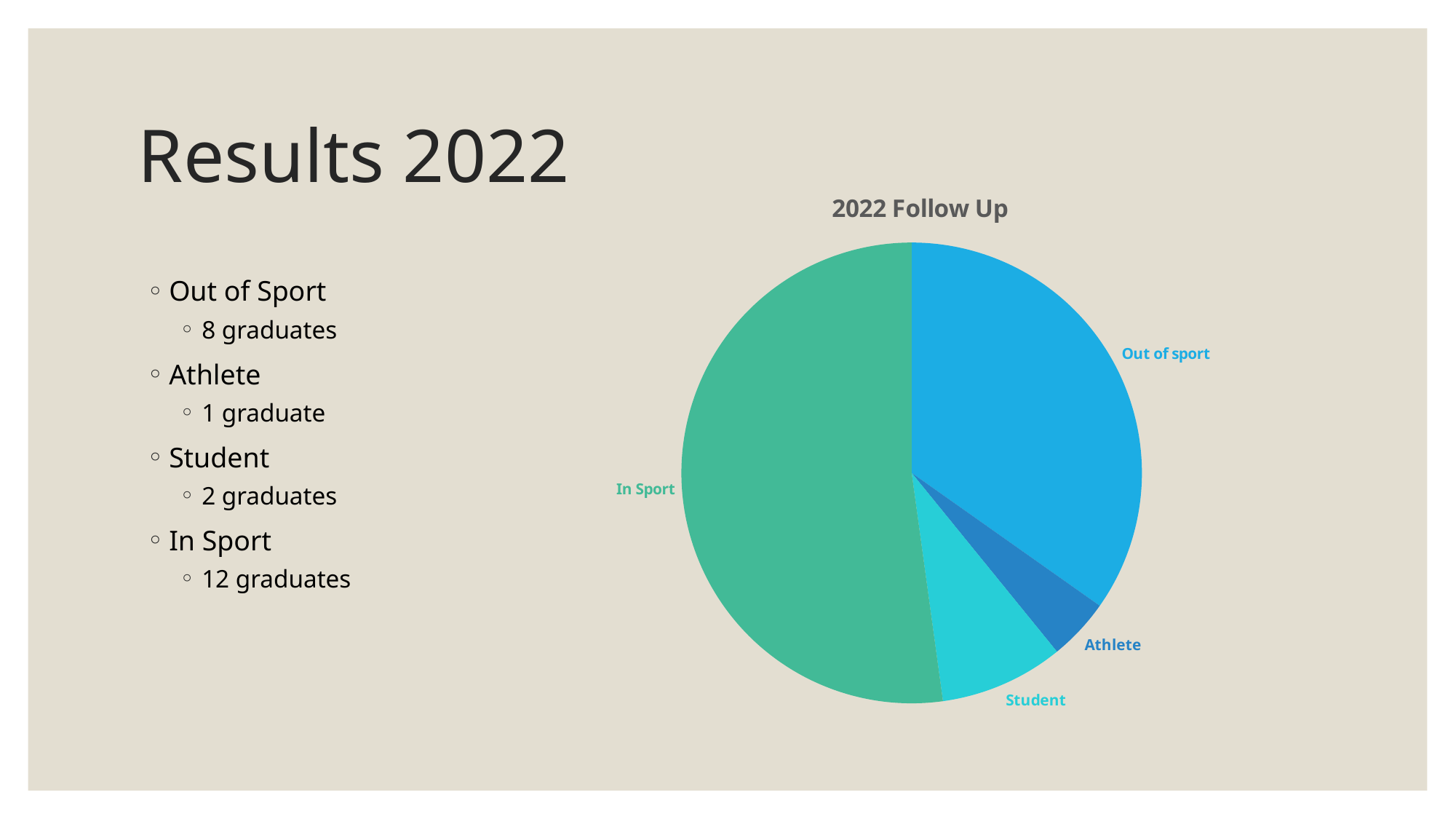
What is the title of the chart? 2022 Follow Up Which category has the largest slice in the pie chart? In Sport Which slice is larger, Student or Athlete? Student What is the total number of graduates across all four categories? 23 What colour is the In Sport slice of the pie chart? Green Which category has the smallest slice in the pie chart? Athlete How many graduates are in the Out of Sport category? 8 graduates How many graduates are in the In Sport category? 12 graduates Which slice is larger, Out of sport or Student? Out of sport How many more graduates are In Sport than Out of Sport? 4 What kind of chart is shown on the slide? Pie chart How many slices does the pie chart have? 4